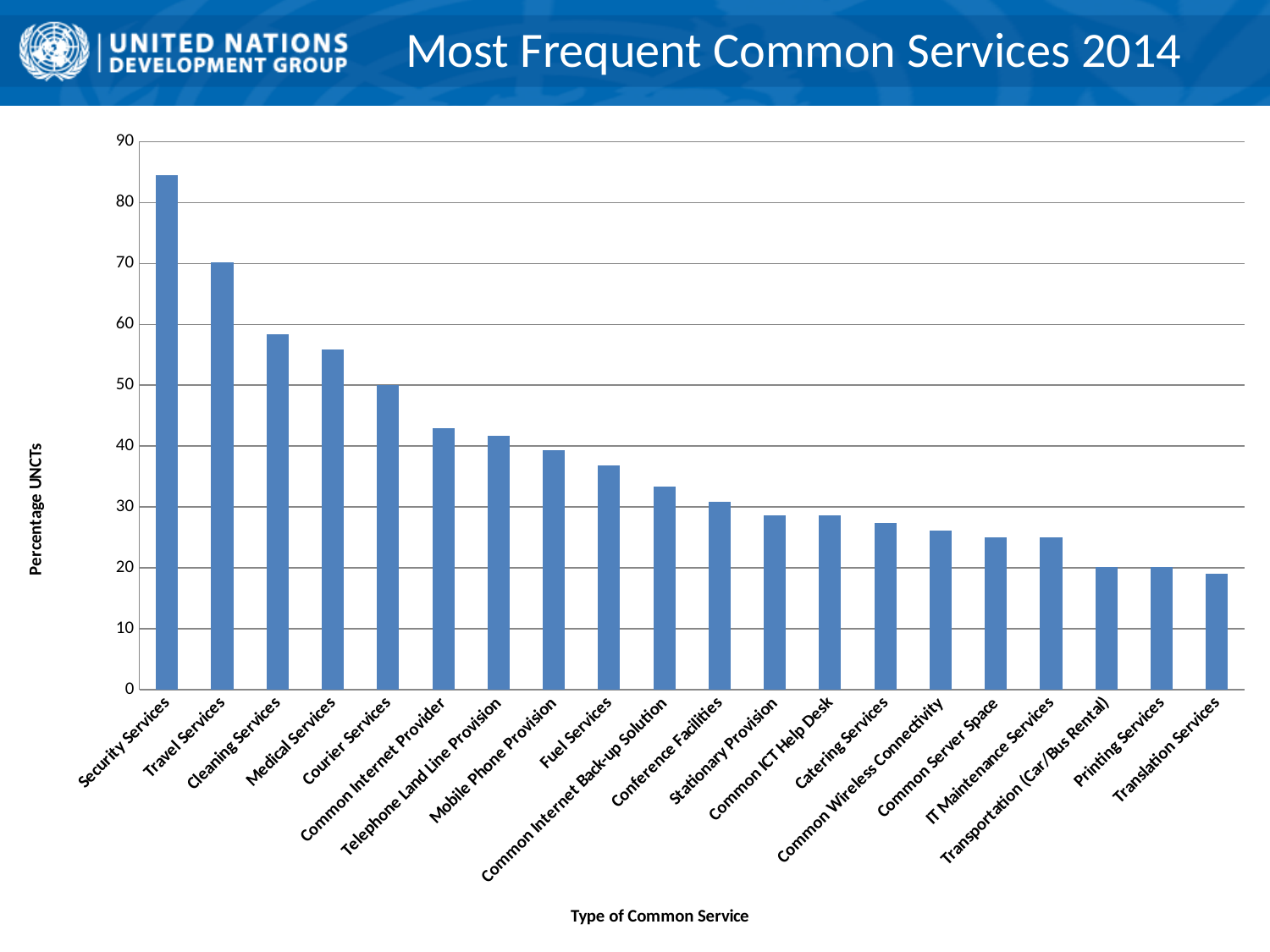
Is the value for Catering Services greater or less than 30? less Which is larger, the value for Fuel Services or the value for Catering Services? Fuel Services Which is larger, the value for Medical Services or the value for Courier Services? Medical Services Which common service has the lowest percentage of UNCTs? Translation Services Is the value for Fuel Services greater or less than 40? less Is the value for Security Services greater or less than 80? greater How many types of common service are plotted on the chart? 20 Do the values rise or fall moving from left to right along the x axis? fall Which common service has the highest percentage of UNCTs? Security Services What is the title of the vertical axis? Percentage UNCTs What kind of chart is shown on the slide? bar chart